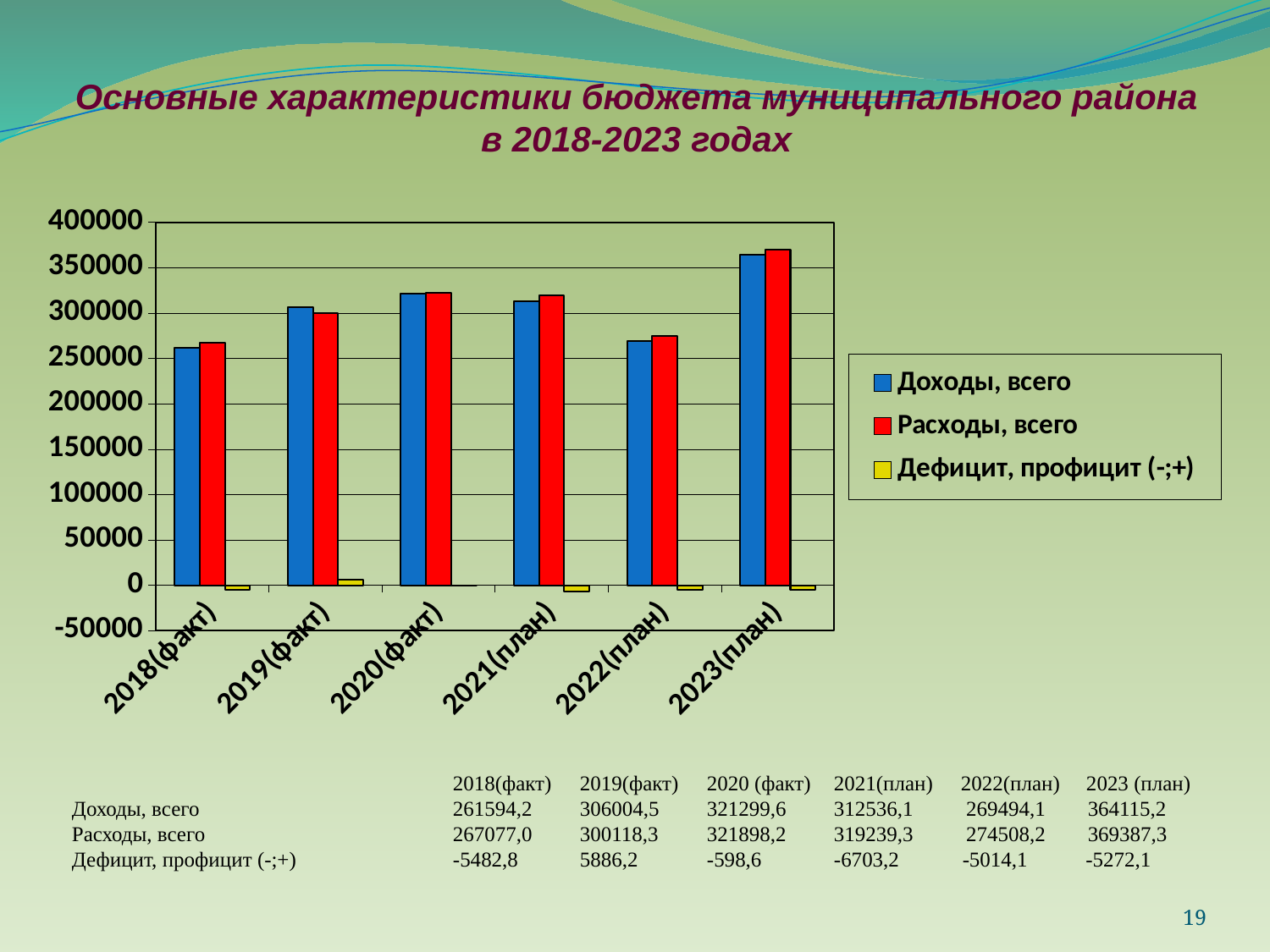
How many years are shown on the x axis of the chart? 6 Which year has the highest value for Доходы, всего? 2023(план) How many series does the legend list? 3 What is the difference between Расходы, всего and Доходы, всего for 2023(план)? 5272,1 What is the value of Доходы, всего for 2023(план)? 364115,2 Which year has the lowest value for Расходы, всего? 2018(факт) What is the value of Расходы, всего for 2018(факт)? 267077,0 Which colour represents Расходы, всего in the chart? red What is the value of Дефицит, профицит (-;+) for 2021(план)? -6703,2 What kind of chart is shown on the slide? bar chart Is the value of Доходы, всего for 2022(план) greater or less than 300000? less For 2019(факт), which is larger: Доходы, всего or Расходы, всего? Доходы, всего